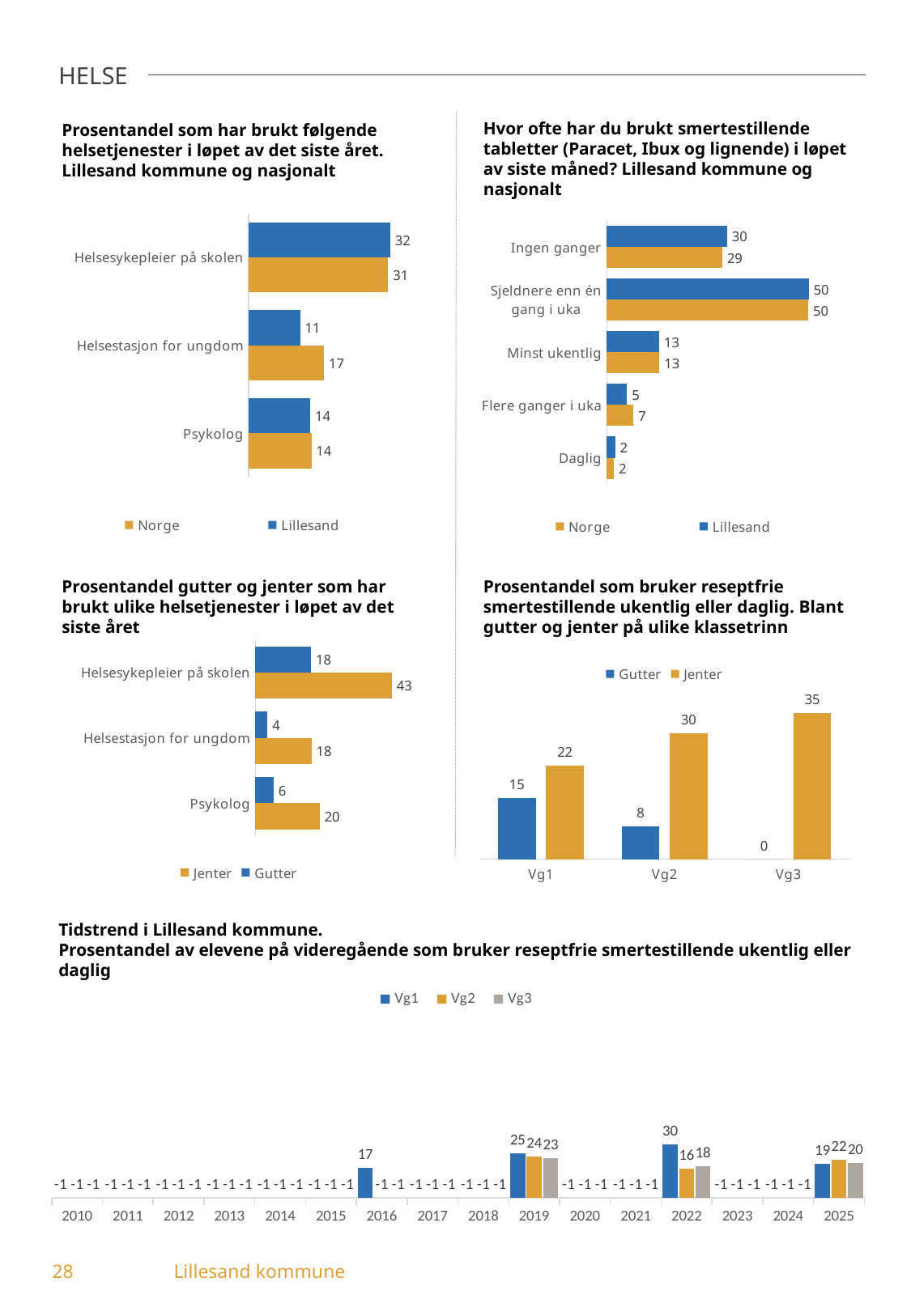
In the chart 'Tidstrend i Lillesand kommune', what is the value for Vg1 in 2022? 30 In the chart 'Prosentandel som har brukt følgende helsetjenester i løpet av det siste året', what is the value for Lillesand for Helsesykepleier på skolen? 32 In the chart 'Prosentandel som har brukt følgende helsetjenester i løpet av det siste året', what is the difference between Norge and Lillesand for Helsestasjon for ungdom? 6 In the chart 'Prosentandel som bruker reseptfrie smertestillende ukentlig eller daglig', what is the value for Gutter at Vg3? 0 In the chart 'Hvor ofte har du brukt smertestillende tabletter', what is the value for Norge for Flere ganger i uka? 7 In the chart 'Prosentandel gutter og jenter som har brukt ulike helsetjenester', what is the value for Jenter for Helsesykepleier på skolen? 43 In the chart 'Tidstrend i Lillesand kommune', how many series does the legend list? 3 In the chart 'Prosentandel gutter og jenter som har brukt ulike helsetjenester', which is larger for Psykolog, Gutter or Jenter? Jenter In the chart 'Hvor ofte har du brukt smertestillende tabletter', how many categories are shown? 5 In the chart 'Prosentandel som bruker reseptfrie smertestillende ukentlig eller daglig', do the Jenter values rise or fall from Vg1 to Vg3? rise In the chart 'Hvor ofte har du brukt smertestillende tabletter', which category has the highest value for Lillesand? Sjeldnere enn én gang i uka What kind of chart is 'Prosentandel som har brukt følgende helsetjenester i løpet av det siste året'? bar chart